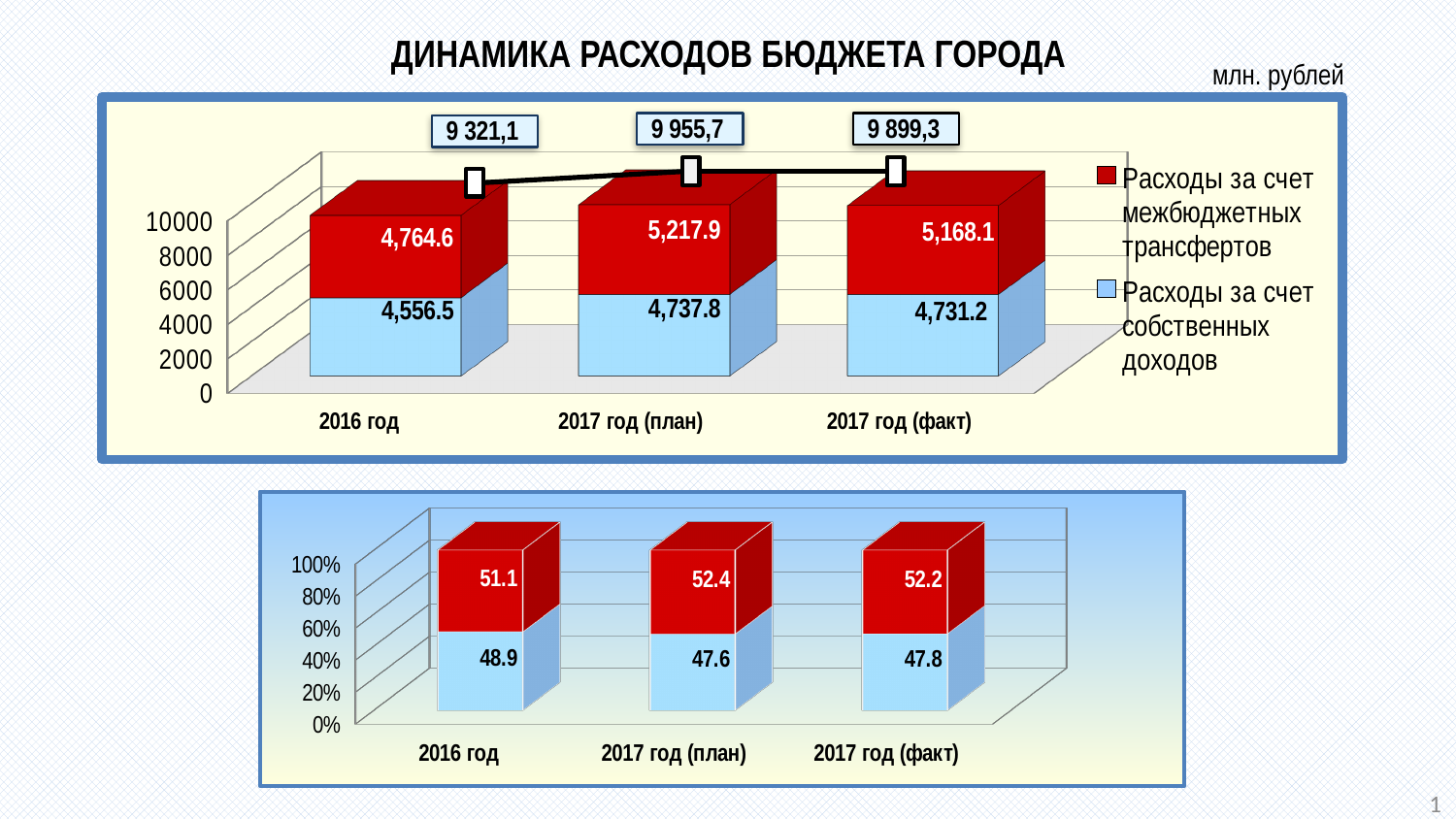
In the top chart, what is the value of Расходы за счет собственных доходов for 2016 год? 4,556.5 How many categories are shown on the x axis of the bottom chart? 3 In the bottom chart, what is the value of the red segment for 2017 год (план)? 52.4 In the bottom chart, what is the value of the blue segment for 2017 год (факт)? 47.8 In the top chart, which is larger for 2016 год: Расходы за счет межбюджетных трансфертов or Расходы за счет собственных доходов? Расходы за счет межбюджетных трансфертов In the top chart, what is the total shown above the bar for 2017 год (факт)? 9 899,3 In the top chart, which category has the highest value for Расходы за счет межбюджетных трансфертов? 2017 год (план) How many series does the legend of the top chart list? 2 In the top chart, what is the value of Расходы за счет межбюджетных трансфертов for 2017 год (план)? 5,217.9 What kind of chart is the top chart? Stacked bar chart In the top chart, what is the difference between Расходы за счет межбюджетных трансфертов for 2017 год (план) and 2017 год (факт)? 49.8 In the top chart, which category has the lowest value for Расходы за счет собственных доходов? 2016 год